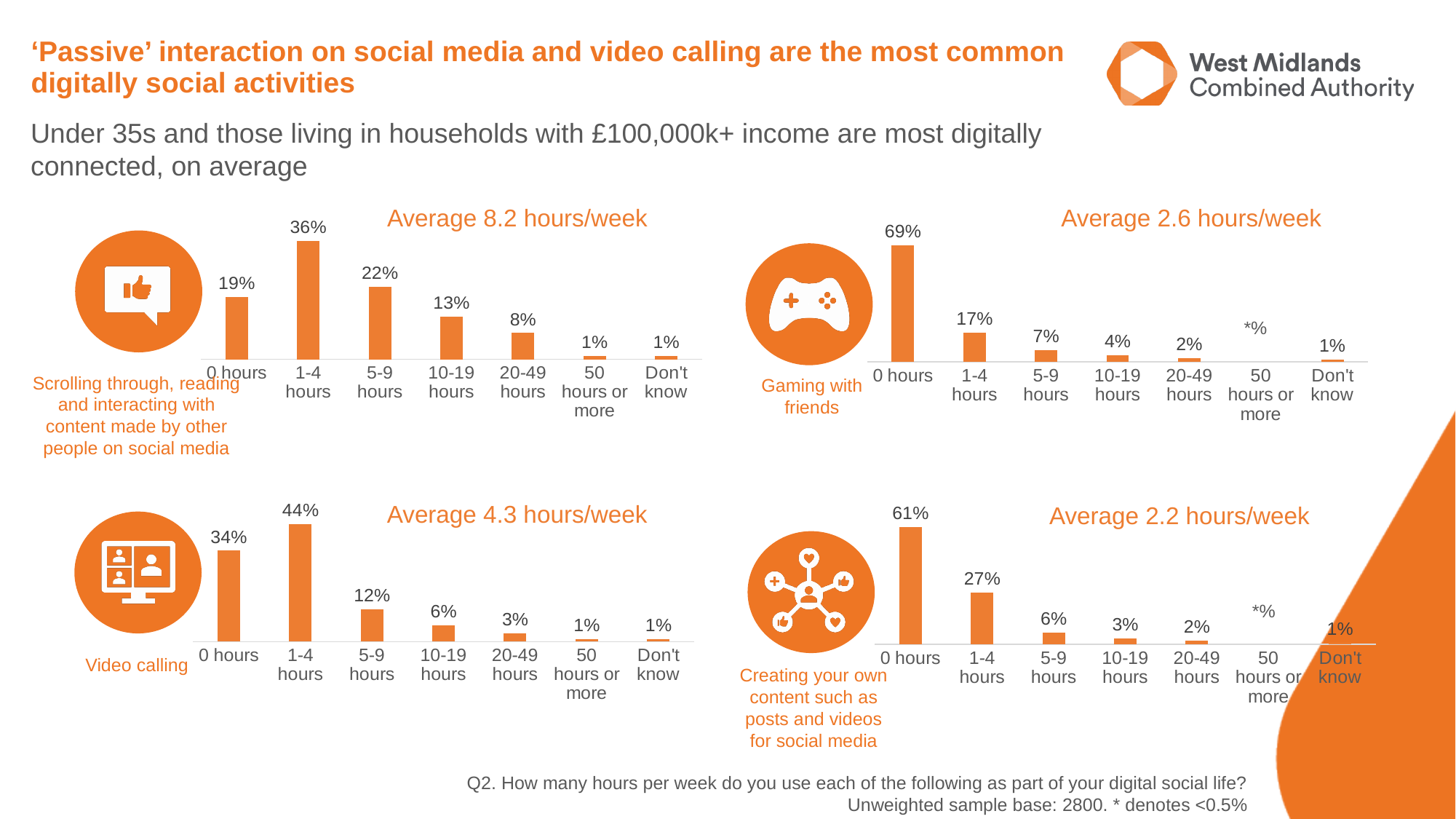
In the 'Gaming with friends' chart, which is larger: the value for 5-9 hours or the value for 10-19 hours? 5-9 hours What type of chart is used for 'Gaming with friends'? Bar chart What average hours per week is shown above the 'Gaming with friends' chart? Average 2.6 hours/week In the 'Creating your own content such as posts and videos for social media' chart, do the values rise or fall from 0 hours to 20-49 hours? Fall In the 'Gaming with friends' chart, what percentage is shown for 0 hours? 69% How many categories are shown on the x axis of the 'Video calling' chart? 7 In the 'Video calling' chart, which category has the highest value? 1-4 hours In the 'Scrolling through, reading and interacting with content made by other people on social media' chart, what percentage is shown for 1-4 hours? 36% In the 'Video calling' chart, what is the difference between the 1-4 hours value and the 0 hours value? 10% In the 'Scrolling through, reading and interacting with content made by other people on social media' chart, what is the difference between the 5-9 hours value and the 10-19 hours value? 9% In the 'Creating your own content such as posts and videos for social media' chart, what is the value for 1-4 hours? 27% What average hours per week is shown above the 'Video calling' chart? Average 4.3 hours/week